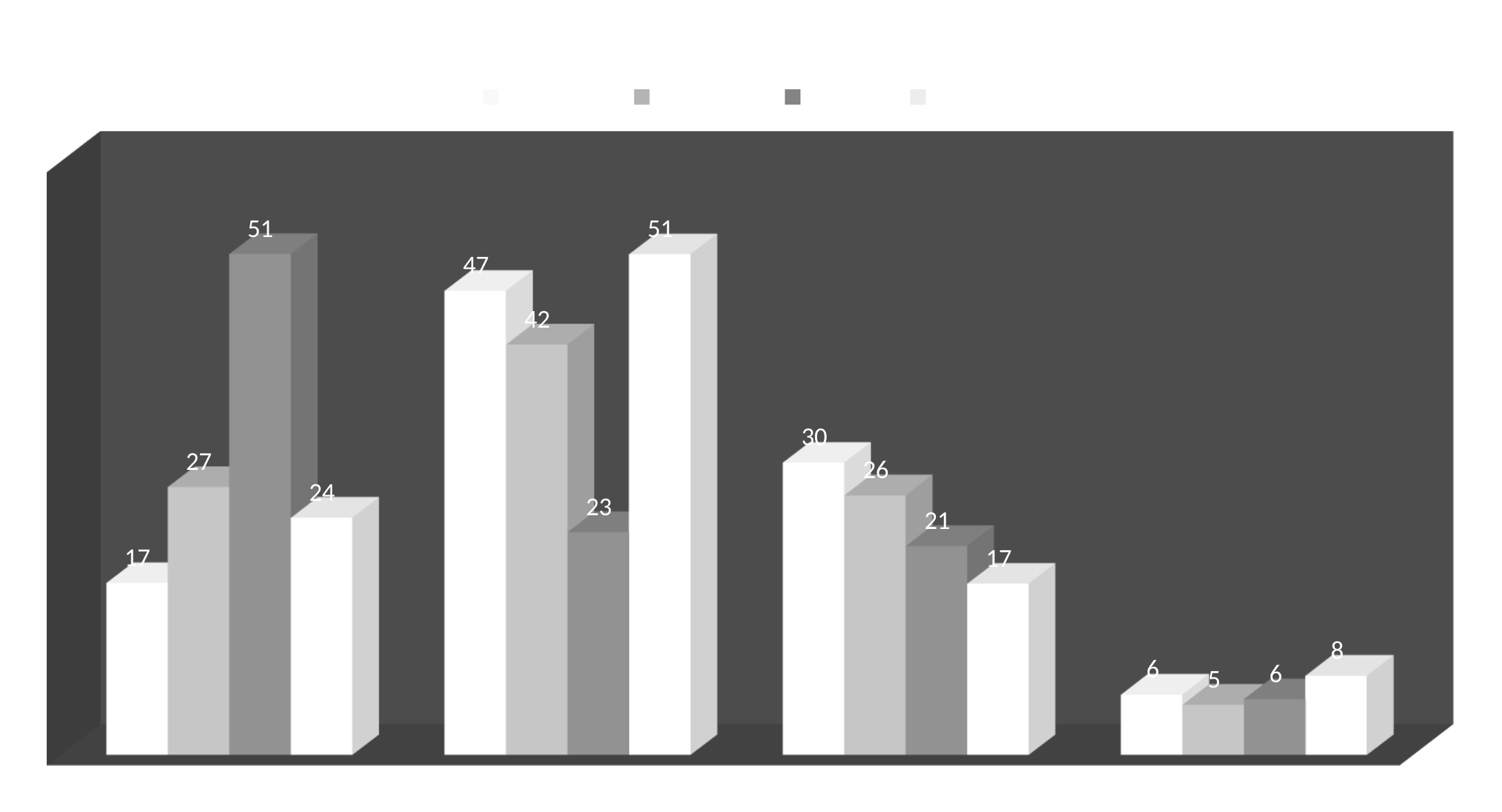
How many groups of bars are plotted along the x axis? 4 In the third group from the left, what is the highest value? 30 In the third group from the left, do the values rise or fall from the first bar to the fourth bar? fall In the rightmost group, what is the lowest value? 5 What kind of chart is shown on the slide? bar chart In the leftmost group, what is the difference between the third bar (51) and the first bar (17)? 34 What is the value of the fourth (rightmost) bar in the second group from the left? 51 What is the value of the tallest bar in the leftmost group? 51 What is the total of the four bars in the rightmost group? 25 What is the value of the first (leftmost) bar in the second group from the left? 47 In the second group from the left, which is larger: the first bar or the second bar? the first bar (47) How many series does the legend list? 4